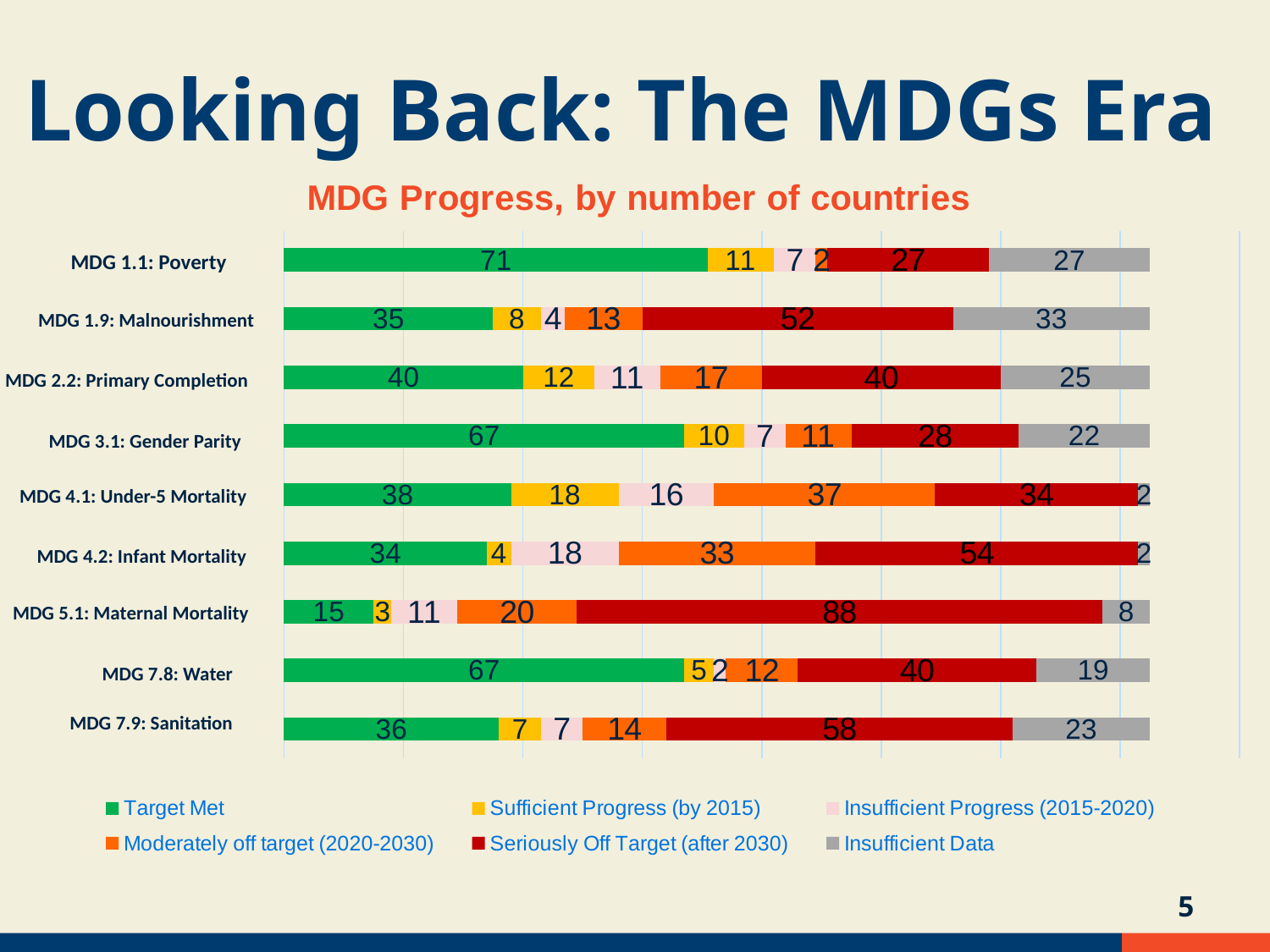
How many MDG categories are plotted in the chart? 9 Which is larger: the Moderately off target (2020-2030) value for MDG 4.1: Under-5 Mortality or for MDG 4.2: Infant Mortality? MDG 4.1: Under-5 Mortality What is the Insufficient Data value for MDG 1.9: Malnourishment? 33 Which MDG has the highest Seriously Off Target (after 2030) value? MDG 5.1: Maternal Mortality What is the total number of countries across all segments for MDG 7.9: Sanitation? 145 Which MDG has the lowest Target Met value? MDG 5.1: Maternal Mortality How many series does the legend list? 6 How many countries have met the target for MDG 1.1: Poverty? 71 What is the Seriously Off Target (after 2030) value for MDG 5.1: Maternal Mortality? 88 What is the title of the chart? MDG Progress, by number of countries What type of chart is shown on the slide? Stacked bar chart What is the difference between the Target Met values for MDG 1.1: Poverty and MDG 7.8: Water? 4